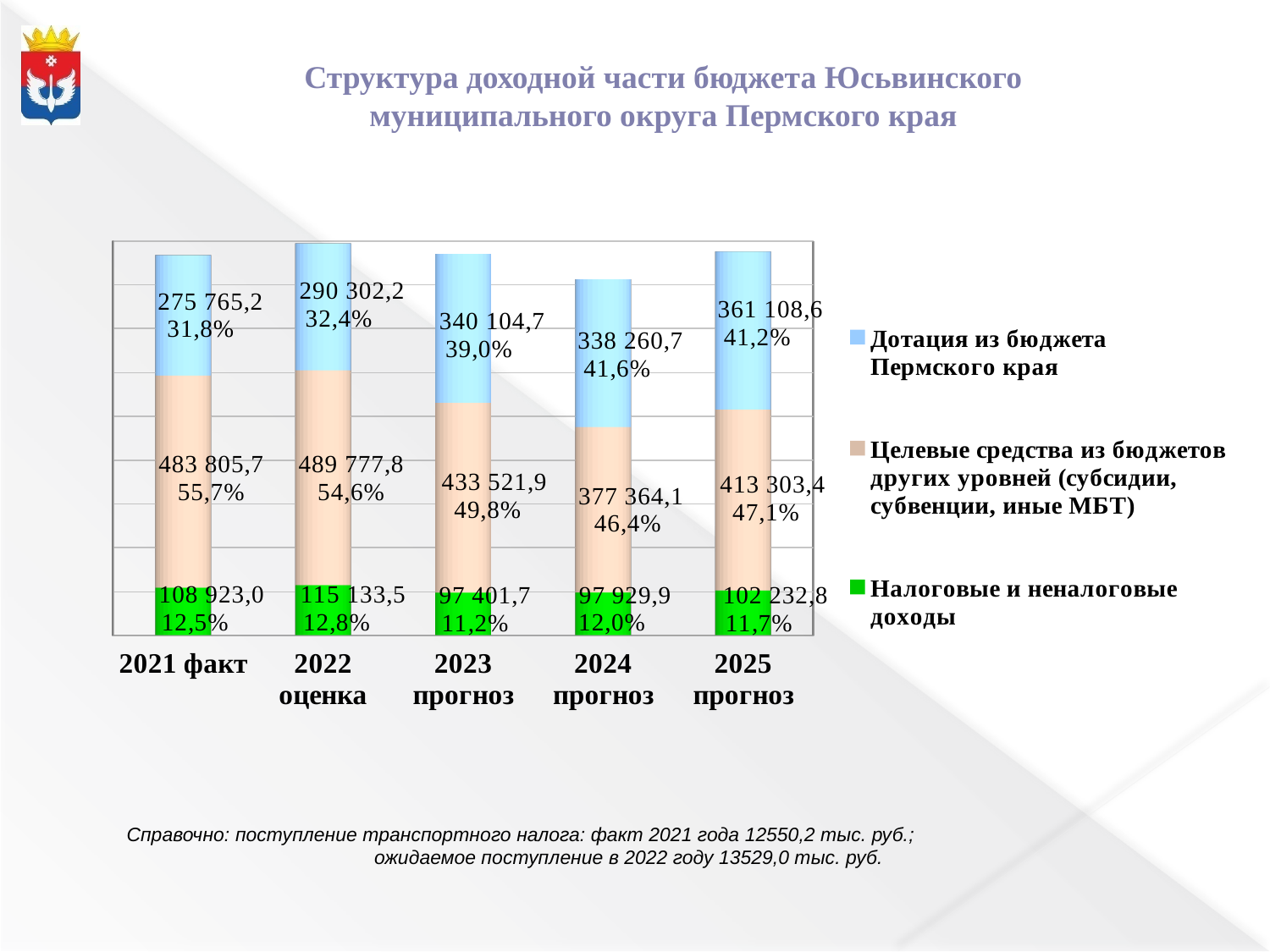
Which is larger: «Дотация из бюджета Пермского края» in 2024 прогноз or in 2025 прогноз? 2025 прогноз What percentage share do «Целевые средства из бюджетов других уровней» have in 2024 прогноз? 46,4% In which year is the value of «Налоговые и неналоговые доходы» the lowest? 2023 прогноз How many series does the legend list? 3 What type of chart is shown on the slide? Stacked bar chart What is the total of the stacked bar for 2021 факт? 868 493,9 What is the value of «Дотация из бюджета Пермского края» for 2023 прогноз? 340 104,7 What is the value of «Налоговые и неналоговые доходы» for 2021 факт? 108 923,0 In which year is the value of «Целевые средства из бюджетов других уровней» the highest? 2022 оценка What is the difference between «Дотация из бюджета Пермского края» in 2025 прогноз and in 2021 факт? 85 343,4 Does the value of «Дотация из бюджета Пермского края» rise or fall from 2021 факт to 2023 прогноз? Rises How many categories (years) are shown on the x axis? 5